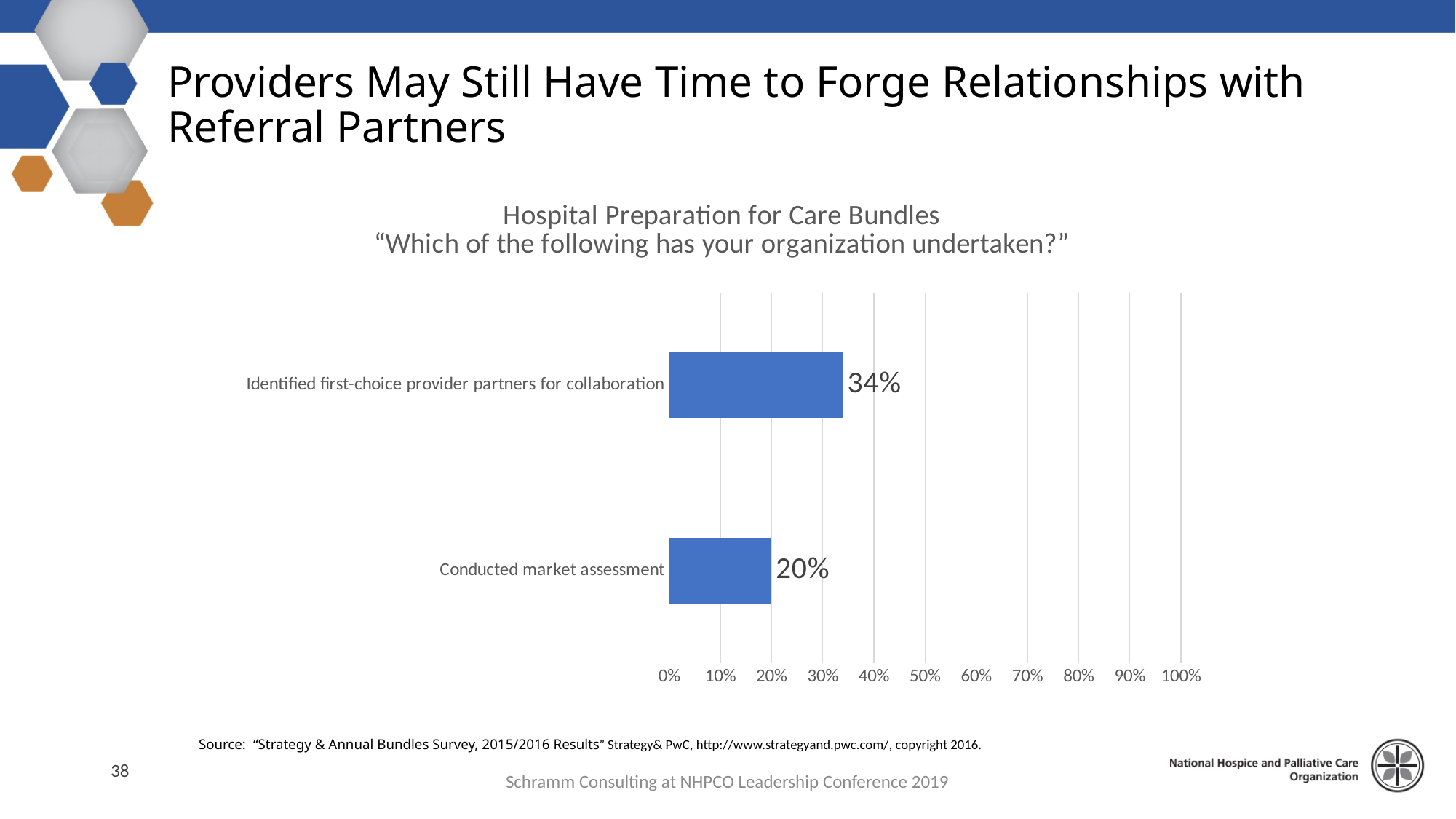
What percentage of organizations identified first-choice provider partners for collaboration? 34% Is the value for 'Identified first-choice provider partners for collaboration' greater or less than 50%? less Which category has the highest value? Identified first-choice provider partners for collaboration Which is larger: the value for 'Conducted market assessment' or 'Identified first-choice provider partners for collaboration'? Identified first-choice provider partners for collaboration What is the difference between the value for 'Identified first-choice provider partners for collaboration' and 'Conducted market assessment'? 14% What is the title of the chart? Hospital Preparation for Care Bundles "Which of the following has your organization undertaken?" What percentage of organizations conducted a market assessment? 20% Which category has the lowest value? Conducted market assessment How many categories are shown in the chart? 2 What kind of chart is shown on the slide? Bar chart What is the maximum value shown on the x axis of the chart? 100%